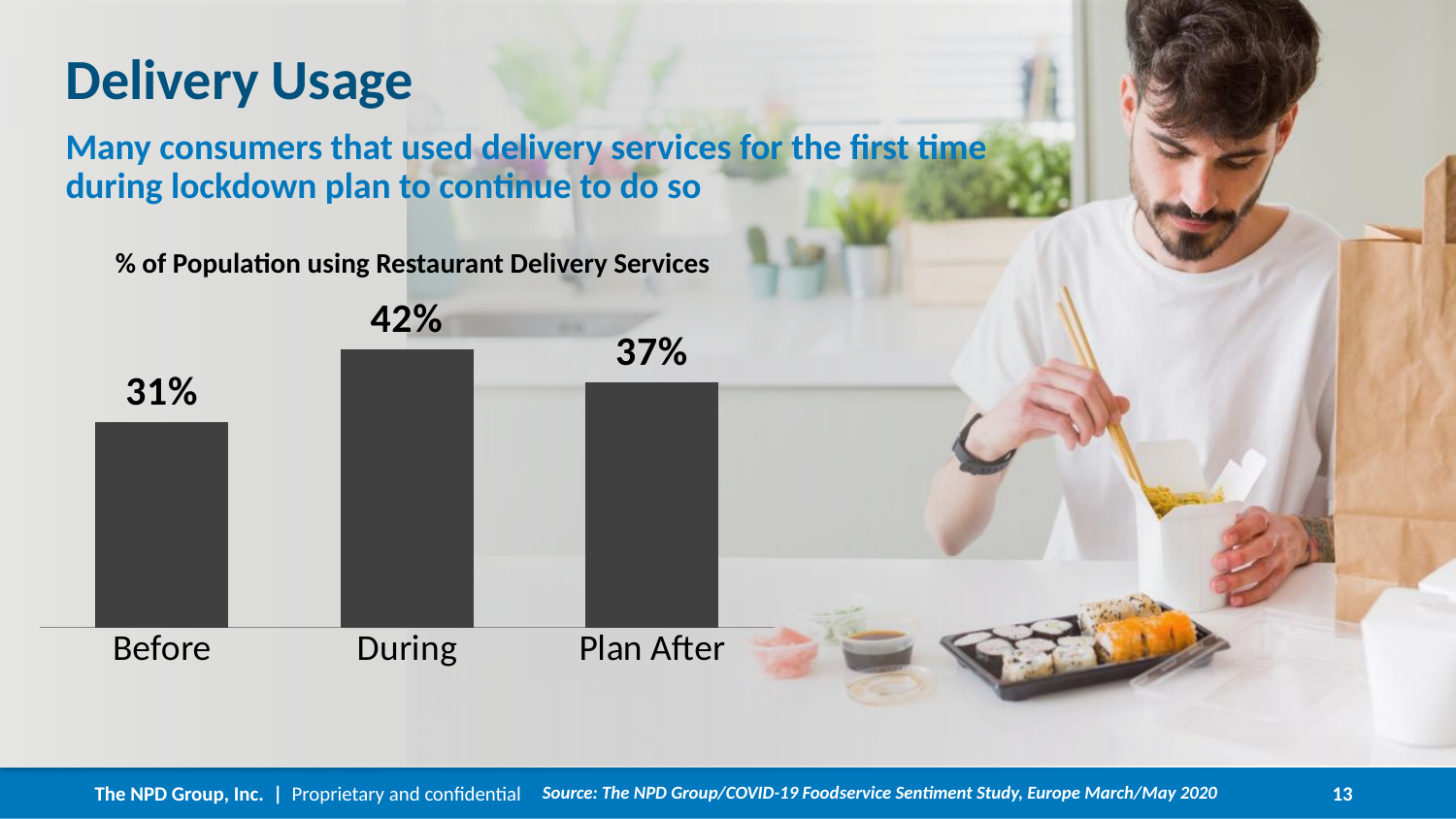
What is the value for During? 42% What is the difference between the During and Before values? 11% What is the value for Before? 31% What is the value for Plan After? 37% What kind of chart is shown on the slide? Bar chart What is the difference between the During and Plan After values? 5% Which category has the highest value? During Which category has the lowest value? Before How many categories are shown in the chart? 3 Which is larger, the value for Plan After or the value for Before? Plan After What is the title of the chart? % of Population using Restaurant Delivery Services Do the values rise or fall from Before to During? Rise